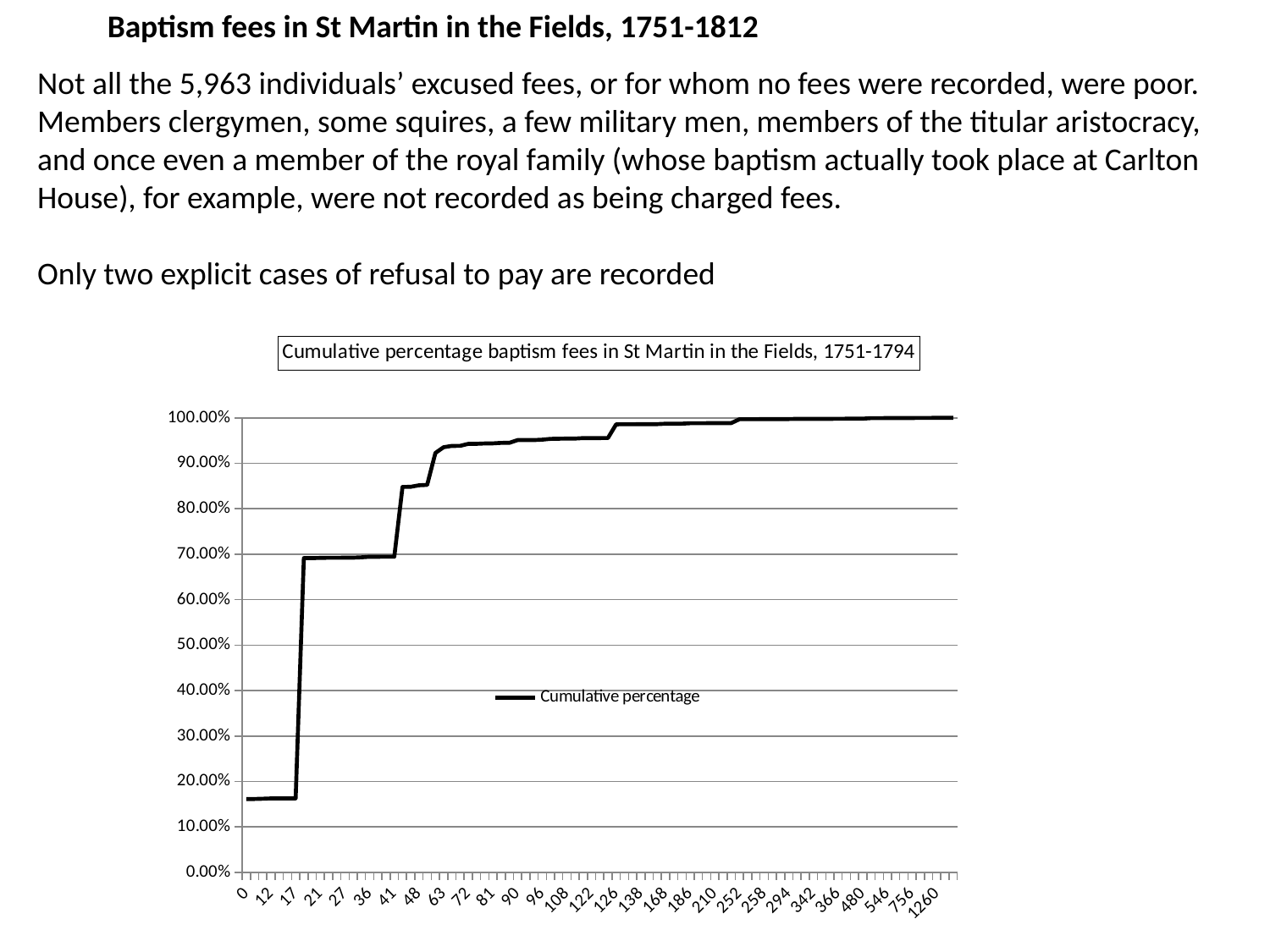
What kind of chart is shown on the slide? line chart Is the cumulative percentage at 1260 greater or less than 90.00%? greater Which has the larger cumulative percentage, 27 or 63? 63 Is the cumulative percentage at 0 greater or less than 20.00%? less Is the cumulative percentage at 36 greater or less than 80.00%? less How many series does the legend list? 1 What is the title of the chart? Cumulative percentage baptism fees in St Martin in the Fields, 1751-1794 Which has the larger cumulative percentage, 12 or 36? 36 Do the values rise or fall along the x axis? rise What is the name of the series shown in the legend? Cumulative percentage